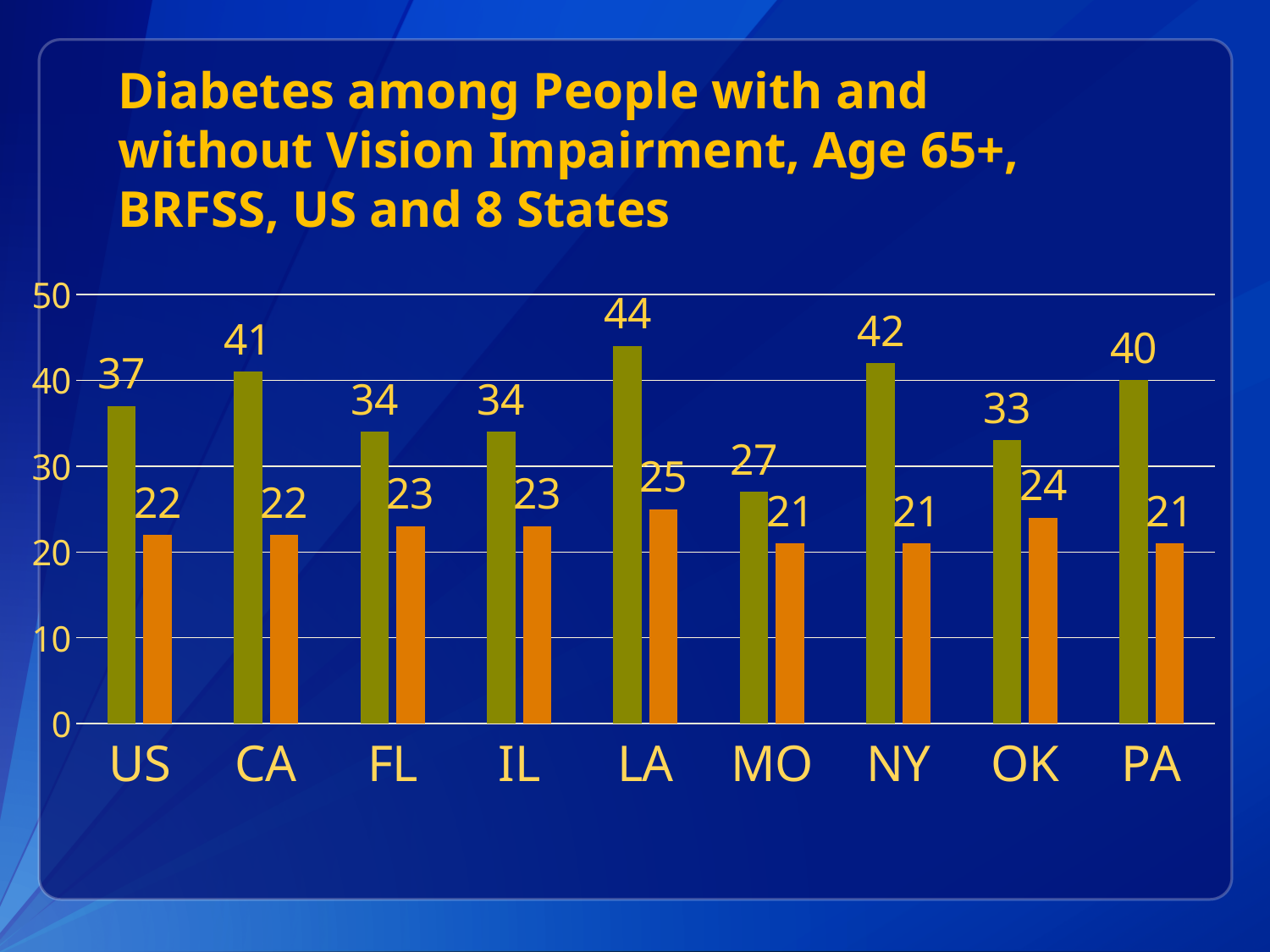
What is the value of the orange bar for OK? 24 What kind of chart is shown on the slide? Bar chart What is the value of the green bar for US? 37 Which category has the lowest green bar? MO Which category has the highest orange bar? LA Which is larger, the green bar for PA or the green bar for OK? PA What is the title of the chart? Diabetes among People with and without Vision Impairment, Age 65+, BRFSS, US and 8 States What is the difference between the green and orange bars for NY? 21 How many categories are shown on the x axis? 9 What is the difference between the green bars for CA and FL? 7 Which category has the highest green bar? LA What is the value of the green bar for LA? 44